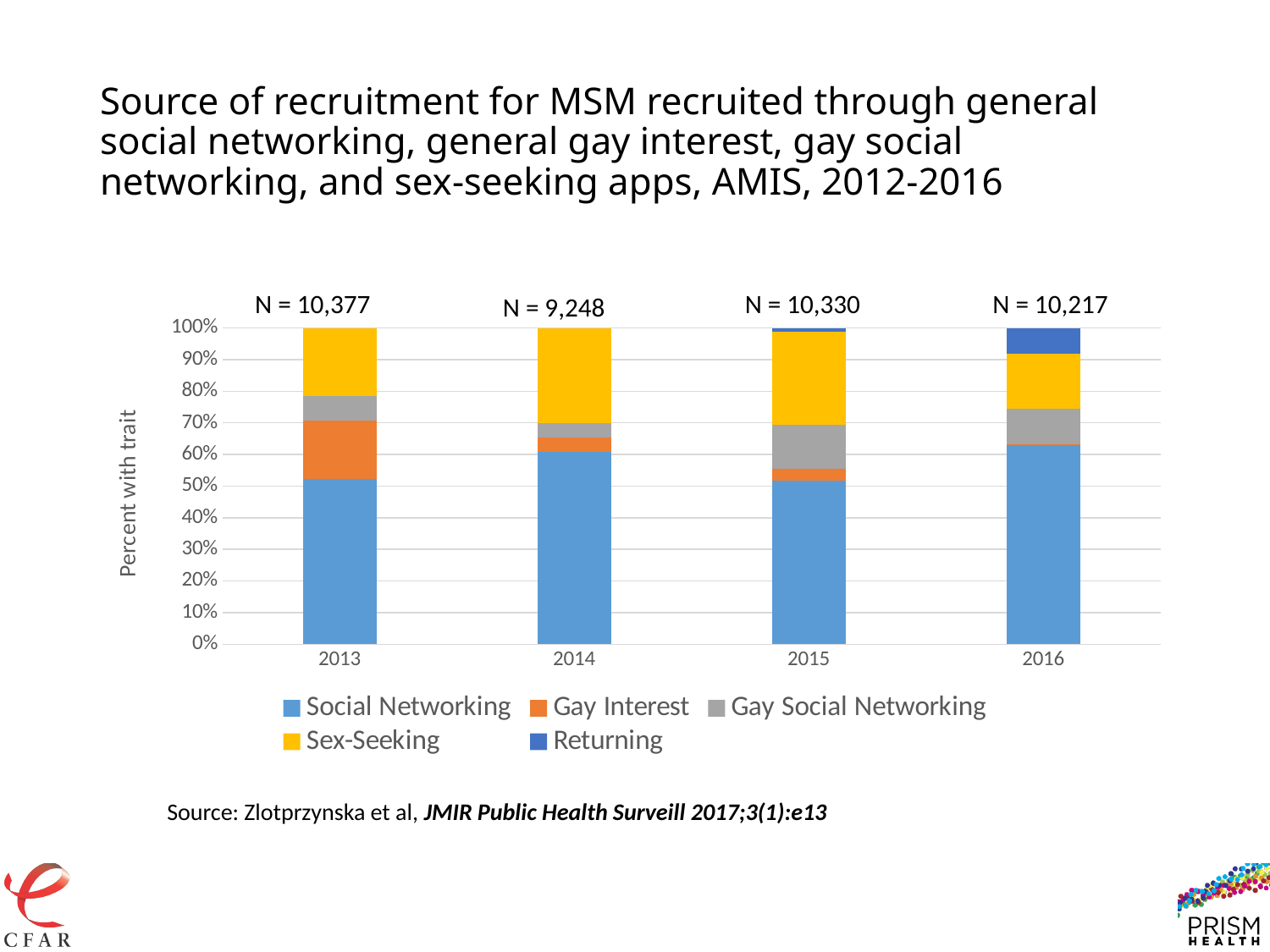
What kind of chart is shown on the slide? Stacked bar chart What is the N value printed above the 2013 bar? N = 10,377 How many years are shown along the x axis of the chart? 4 Does the Gay Interest segment rise or fall from 2013 to 2016? fall What is the label on the vertical axis of the chart? Percent with trait Which year has the larger Gay Interest segment, 2013 or 2014? 2013 What is the N value printed above the 2014 bar? N = 9,248 How many series does the chart legend list? 5 Which year has the smallest N printed above its bar? 2014 Which year has the largest N printed above its bar? 2013 Is the Social Networking share for 2013 greater or less than 60%? less What is the difference between the N for 2013 and the N for 2014? 1,129